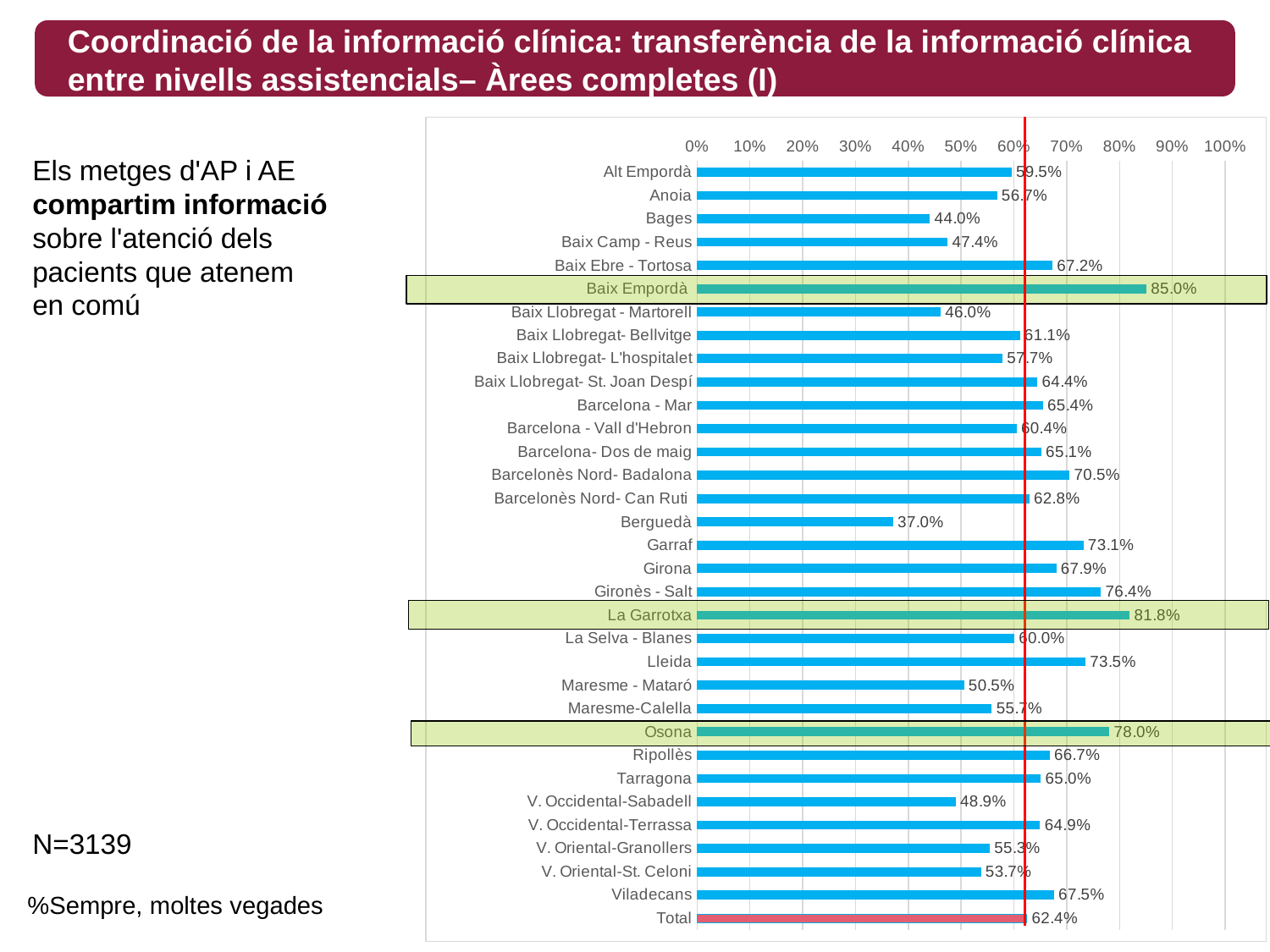
What is the difference between the values for Baix Empordà and Berguedà? 48.0 percentage points What is the value for Berguedà? 37.0% Which is larger, the value for Gironès - Salt or the value for Girona? Gironès - Salt Which area has the highest value? Baix Empordà Is the value for Bages greater or less than 50%? less How many bars are plotted in the chart, including Total? 33 What is the difference between the values for Osona and Total? 15.6 percentage points Which three areas are highlighted with a green background in the chart? Baix Empordà, La Garrotxa, Osona What is the value for Baix Empordà? 85.0% What is the value for the Total bar? 62.4% Which area has the lowest value? Berguedà What kind of chart is shown on the slide? bar chart